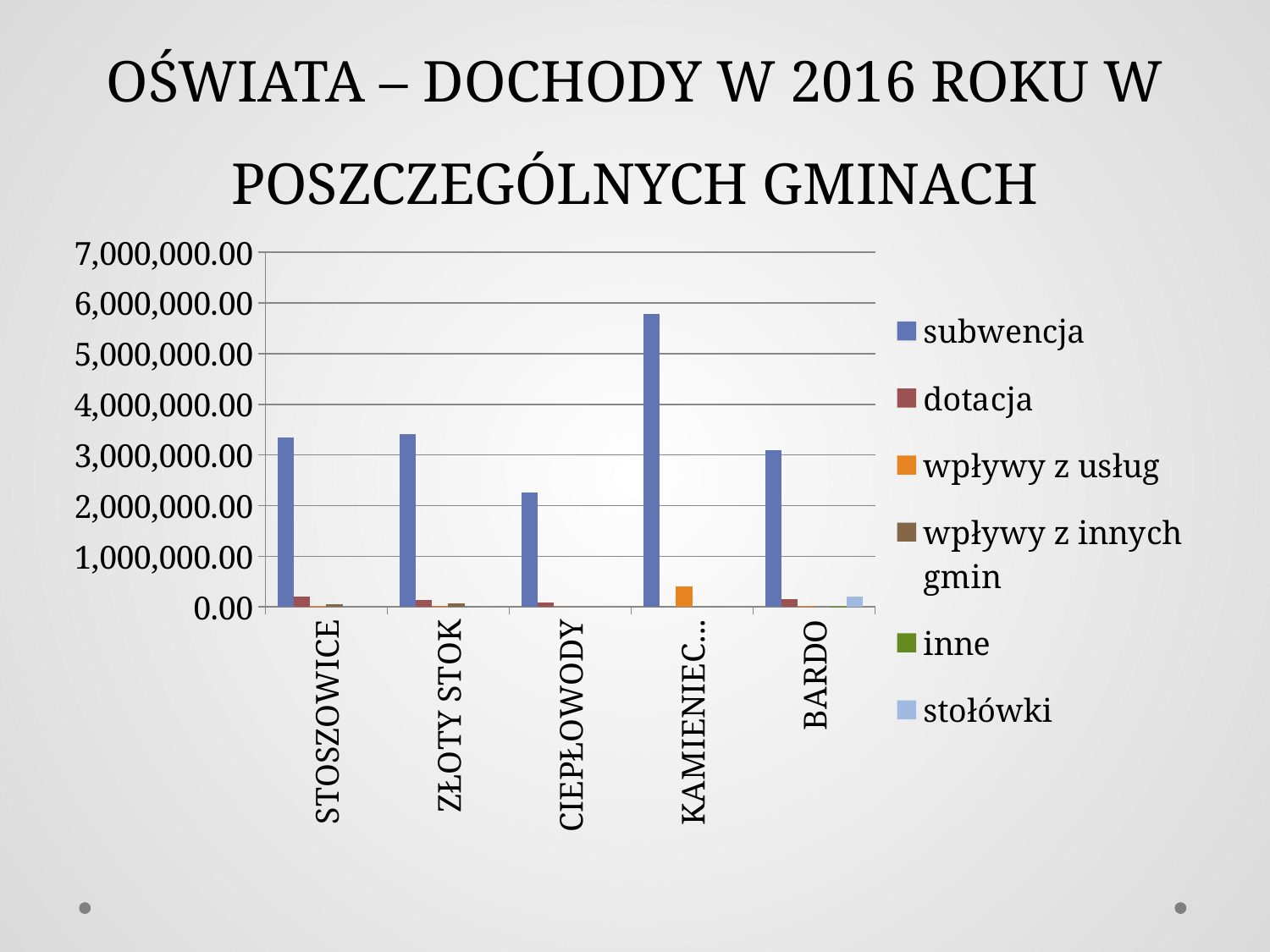
Which gmina has the lowest subwencja value? CIEPŁOWODY Is the subwencja value for CIEPŁOWODY greater or less than 3,000,000.00? less Is the subwencja value for KAMIENIEC… greater or less than 5,000,000.00? greater Is the subwencja value for STOSZOWICE greater or less than 4,000,000.00? less Which series is shown in blue in the legend? subwencja How many gminas (categories) are shown on the x axis? 5 Which has the larger subwencja value, CIEPŁOWODY or STOSZOWICE? STOSZOWICE How many series does the legend list? 6 Which gmina has the highest subwencja value? KAMIENIEC… Which has the larger subwencja value, KAMIENIEC… or BARDO? KAMIENIEC… What kind of chart is shown on the slide? bar chart